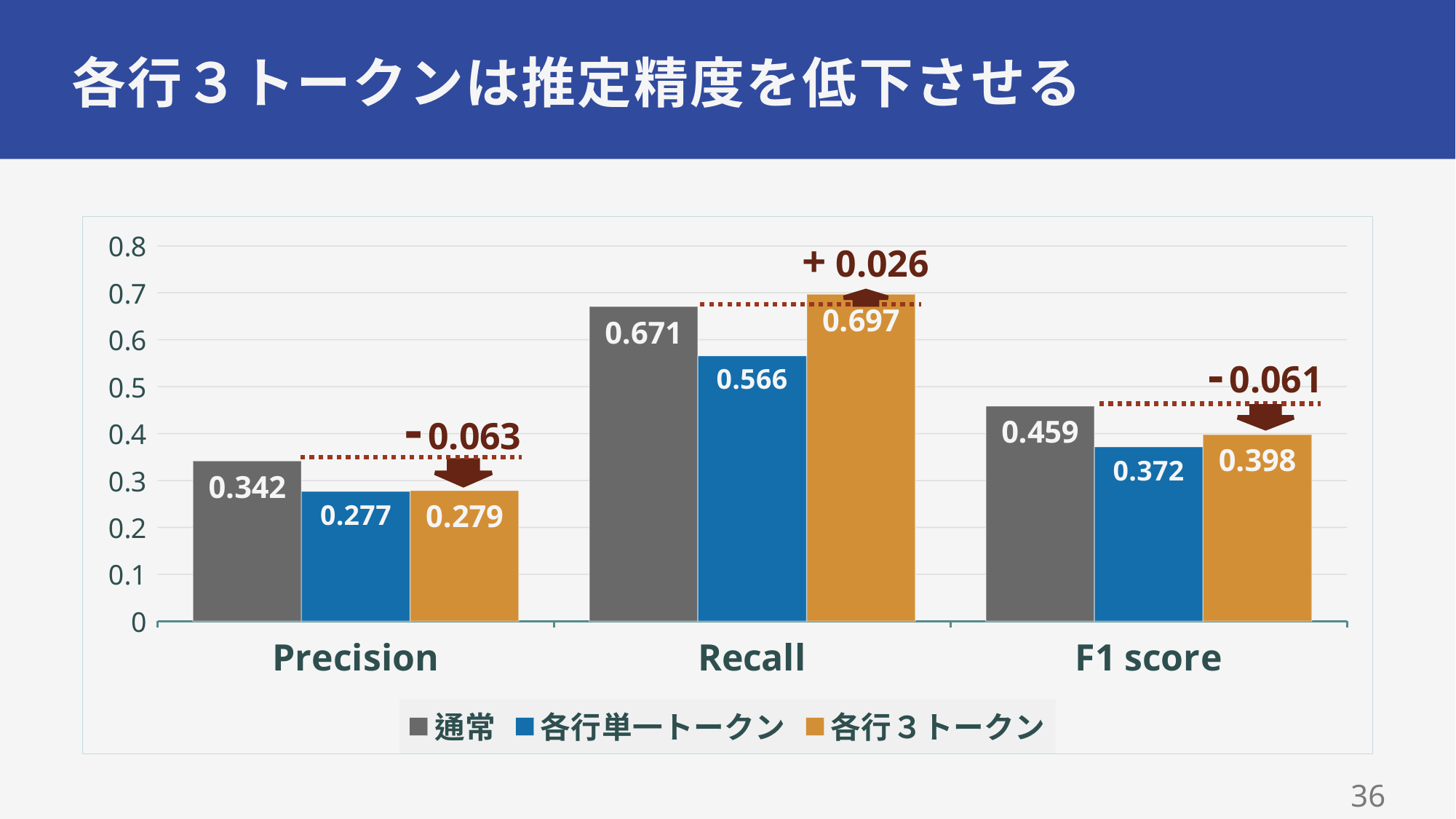
How many categories are shown on the x axis? 3 For F1 score, which is larger: the 通常 value or the 各行単一トークン value? 通常 How many series does the legend list? 3 What is the F1 score value for the 各行３トークン series? 0.398 What is the Recall value for the 通常 series? 0.671 Which category has the highest value for the 通常 series? Recall Is the Recall value for the 各行単一トークン series greater or less than 0.5? greater What is the Precision value for the 各行単一トークン series? 0.277 What kind of chart is shown on the slide? bar chart What is the difference between the 通常 and 各行３トークン values for Precision? 0.063 Which category has the lowest value for the 各行３トークン series? Precision What is the difference between the 各行３トークン and 通常 values for Recall? 0.026